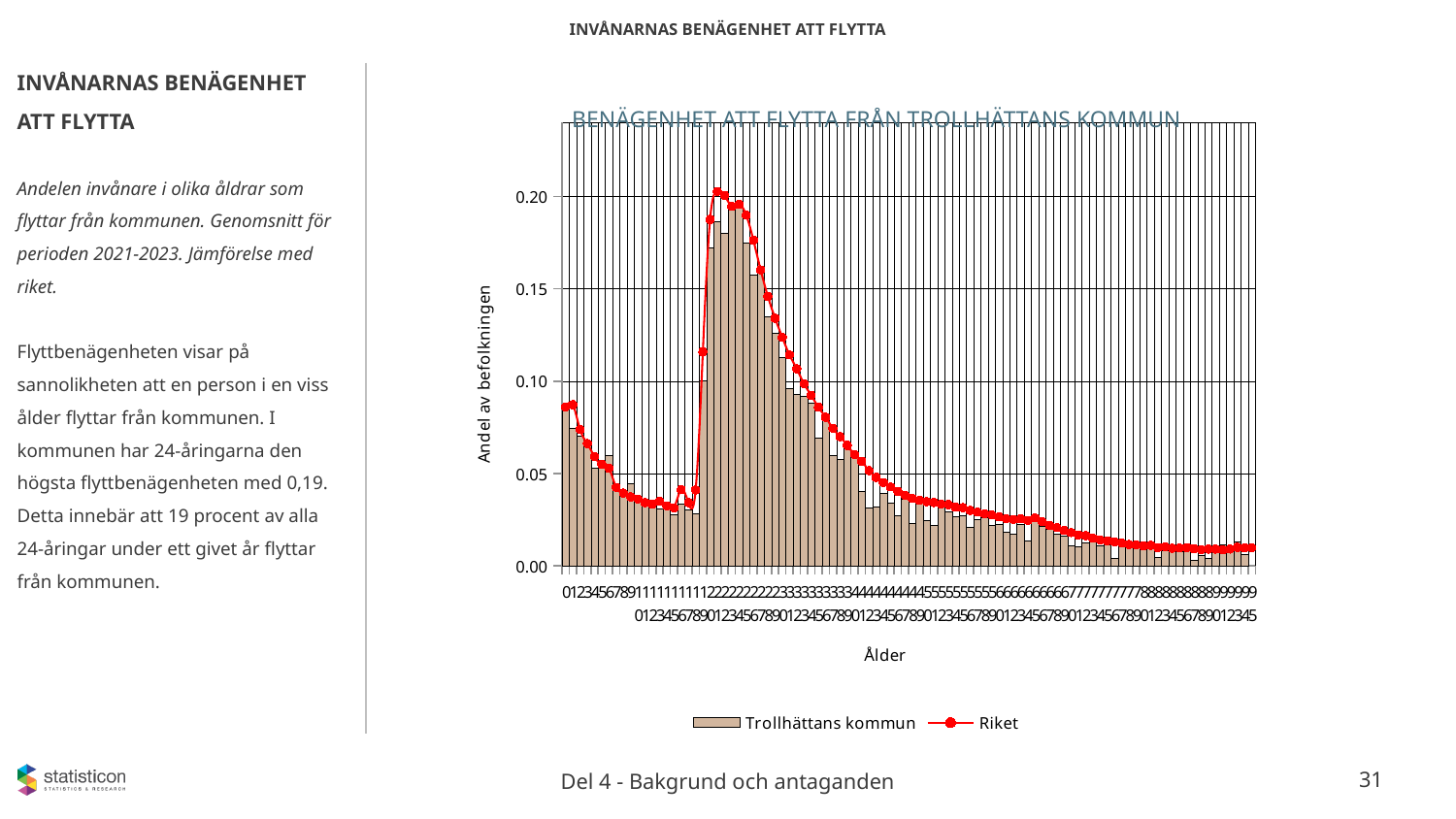
What is the label of the horizontal axis? Ålder Is the value for Trollhättans kommun at age 0 greater or less than 0.10? less What is the title of the chart? BENÄGENHET ATT FLYTTA FRÅN TROLLHÄTTANS KOMMUN How many series does the chart legend list? 2 What is the highest tick value shown on the vertical axis? 0.20 Is the highest bar for Trollhättans kommun greater or less than 0.15? greater Do the values for Riket rise or fall along the x axis between age 30 and age 60? fall Is the peak value of the Riket line greater or less than 0.15? greater